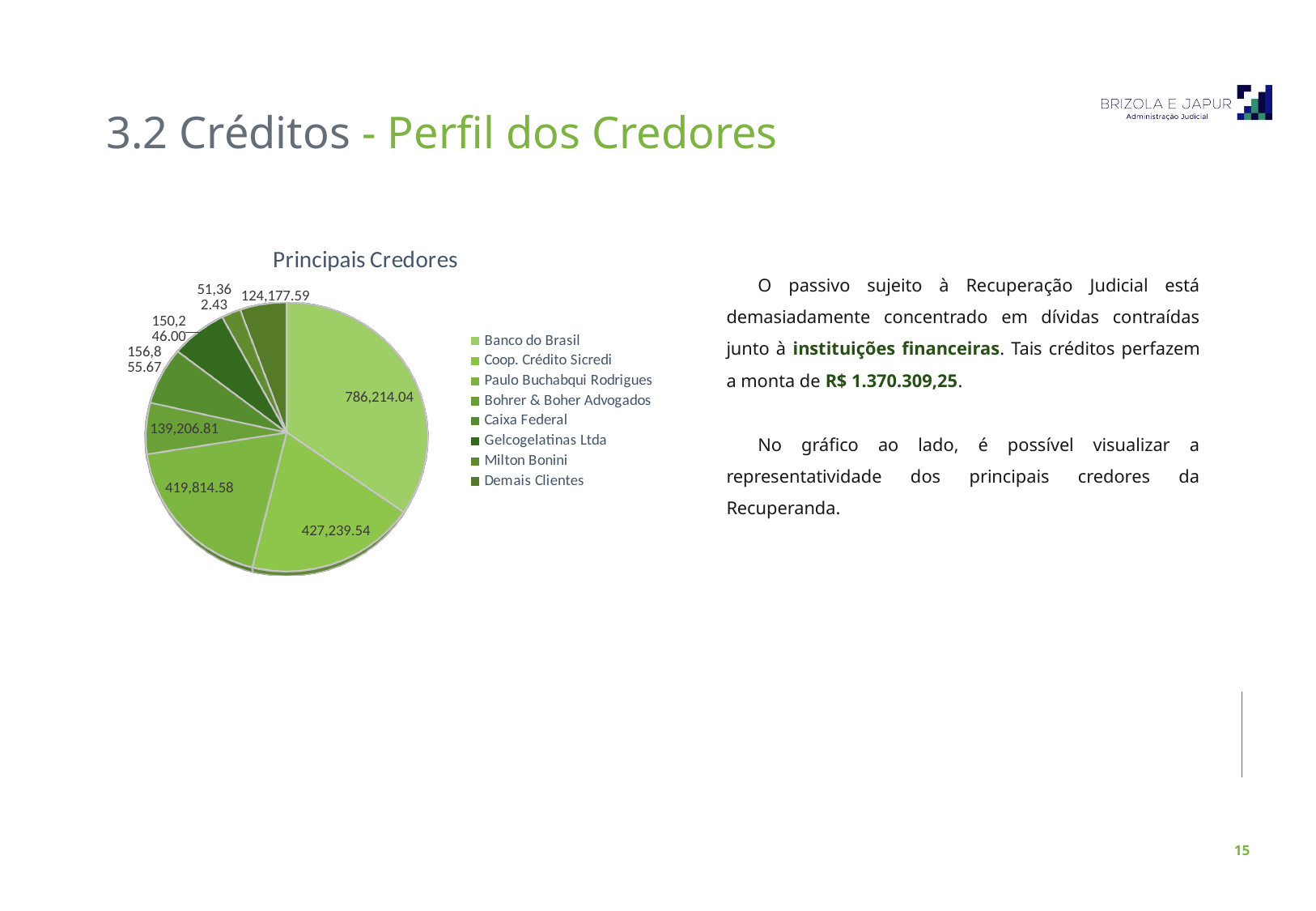
What is the value shown for Bohrer & Boher Advogados? 139,206.81 What is the title of the chart? Principais Credores What is the value shown for Paulo Buchabqui Rodrigues? 419,814.58 What is the difference between the values for Banco do Brasil and Coop. Crédito Sicredi? 358,974.50 Which is larger, the value for Coop. Crédito Sicredi or the value for Paulo Buchabqui Rodrigues? Coop. Crédito Sicredi Which creditor has the largest slice of the pie? Banco do Brasil What is the value shown for Demais Clientes? 124,177.59 How many creditor categories does the pie chart show? 8 What kind of chart is shown on the slide? Pie chart What is the value shown for Banco do Brasil? 786,214.04 Which creditor has the smallest slice of the pie? Milton Bonini What is the value shown for Coop. Crédito Sicredi? 427,239.54